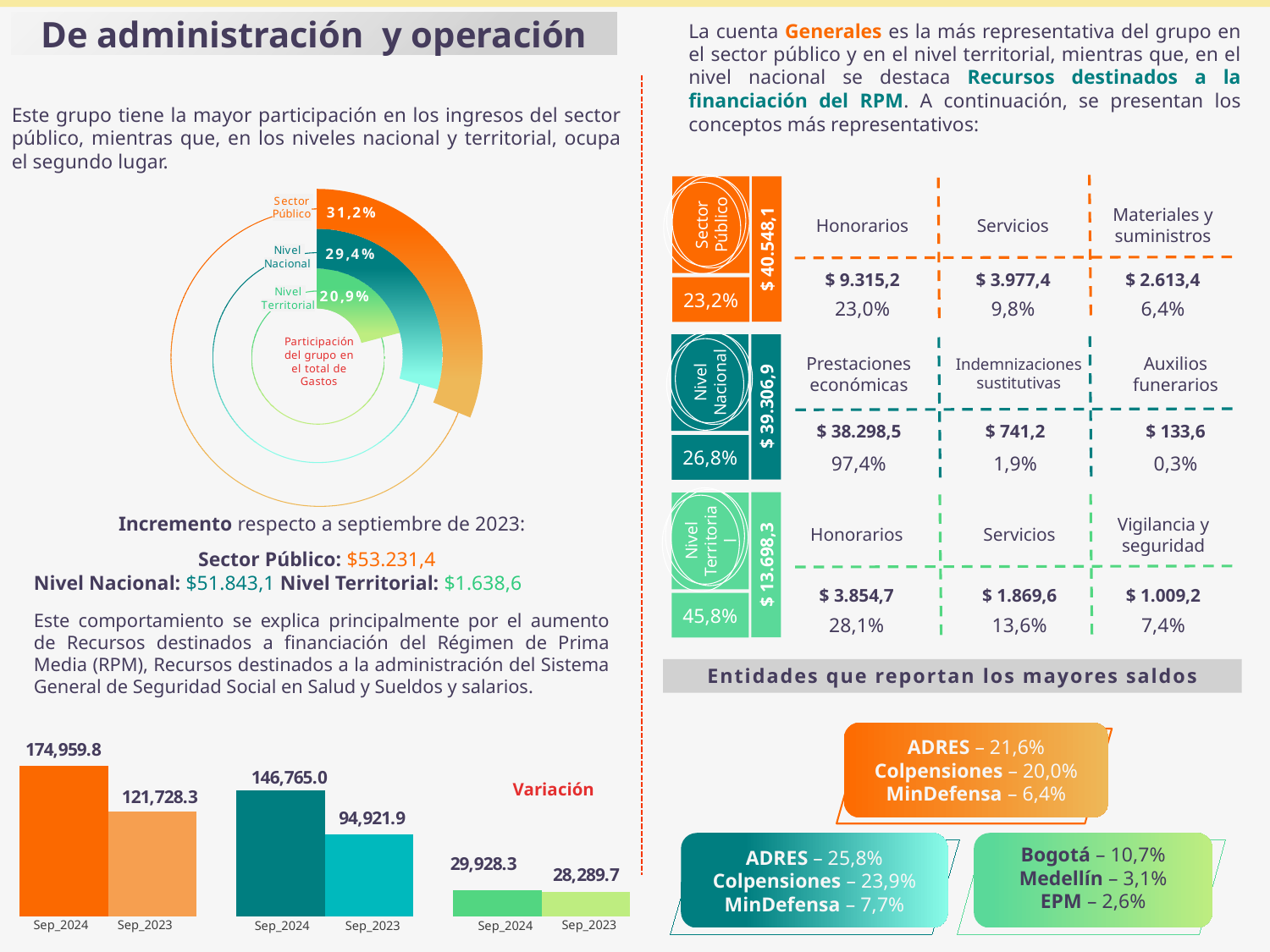
In the bar chart at the bottom left of the slide, what is the difference between Sep_2024 and Sep_2023 in the middle (teal) group? 51,843.1 What kind of chart is shown at the bottom left of the slide? Bar chart In the radial chart titled 'Participación del grupo en el total de Gastos', which level has the lowest participation? Nivel Territorial In the radial chart titled 'Participación del grupo en el total de Gastos', what is the difference between Sector Público and Nivel Nacional? 1,8% In the radial chart titled 'Participación del grupo en el total de Gastos', which level has the highest participation? Sector Público In the radial chart titled 'Participación del grupo en el total de Gastos', what is the value for Nivel Territorial? 20,9% In the radial chart titled 'Participación del grupo en el total de Gastos', what is the value for Sector Público? 31,2% In the bar chart at the bottom left of the slide, which is larger in the rightmost (green) group: Sep_2024 or Sep_2023? Sep_2024 In the radial chart titled 'Participación del grupo en el total de Gastos', how many levels are shown? 3 In the bar chart at the bottom left of the slide, what is the Sep_2024 value of the leftmost (orange) group? 174,959.8 In the bar chart at the bottom left of the slide, what is the Sep_2023 value of the middle (teal) group? 94,921.9 In the bar chart at the bottom left of the slide, what is the difference between Sep_2024 and Sep_2023 in the rightmost (green) group? 1,638.6